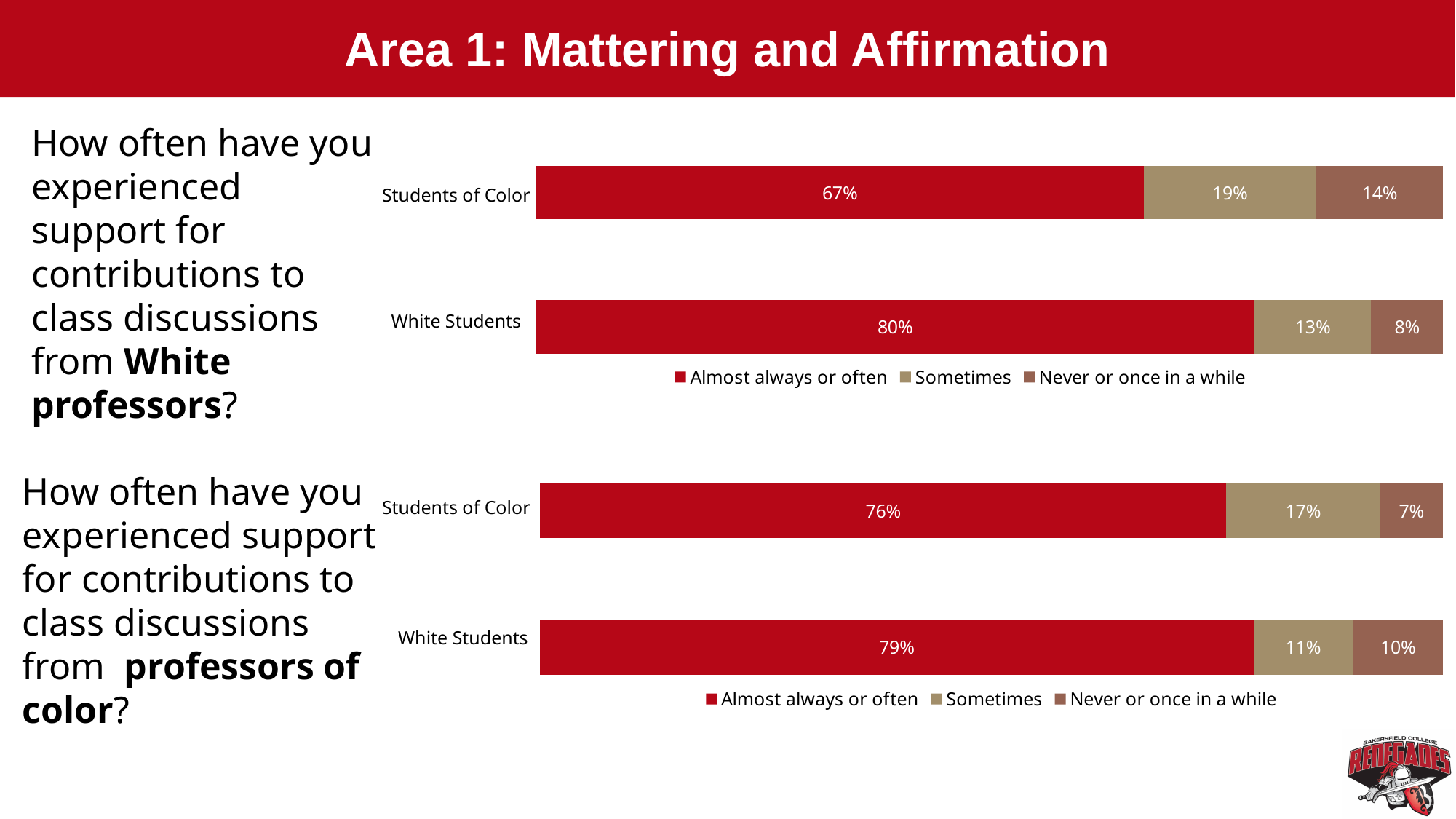
In the top chart, which legend entry is shown in red? Almost always or often In the bottom chart (support from professors of color), what is the difference between the 'Never or once in a while' percentages for White Students and Students of Color? 3% How many student groups are shown in the bottom chart? 2 In the bottom chart (support from professors of color), what percentage of Students of Color answered 'Never or once in a while'? 7% In the top chart (support from White professors), what is the difference between the 'Almost always or often' percentages for White Students and Students of Color? 13% How many series does the legend of the top chart list? 3 In the top chart (support from White professors), what percentage of Students of Color answered 'Almost always or often'? 67% In the top chart (support from White professors), which group has the higher 'Almost always or often' percentage? White Students In the top chart (support from White professors), what percentage of White Students answered 'Sometimes'? 13% In the bottom chart (support from professors of color), which group has the higher 'Sometimes' percentage? Students of Color What kind of chart is the top chart? Stacked bar chart In the bottom chart (support from professors of color), what percentage of White Students answered 'Almost always or often'? 79%